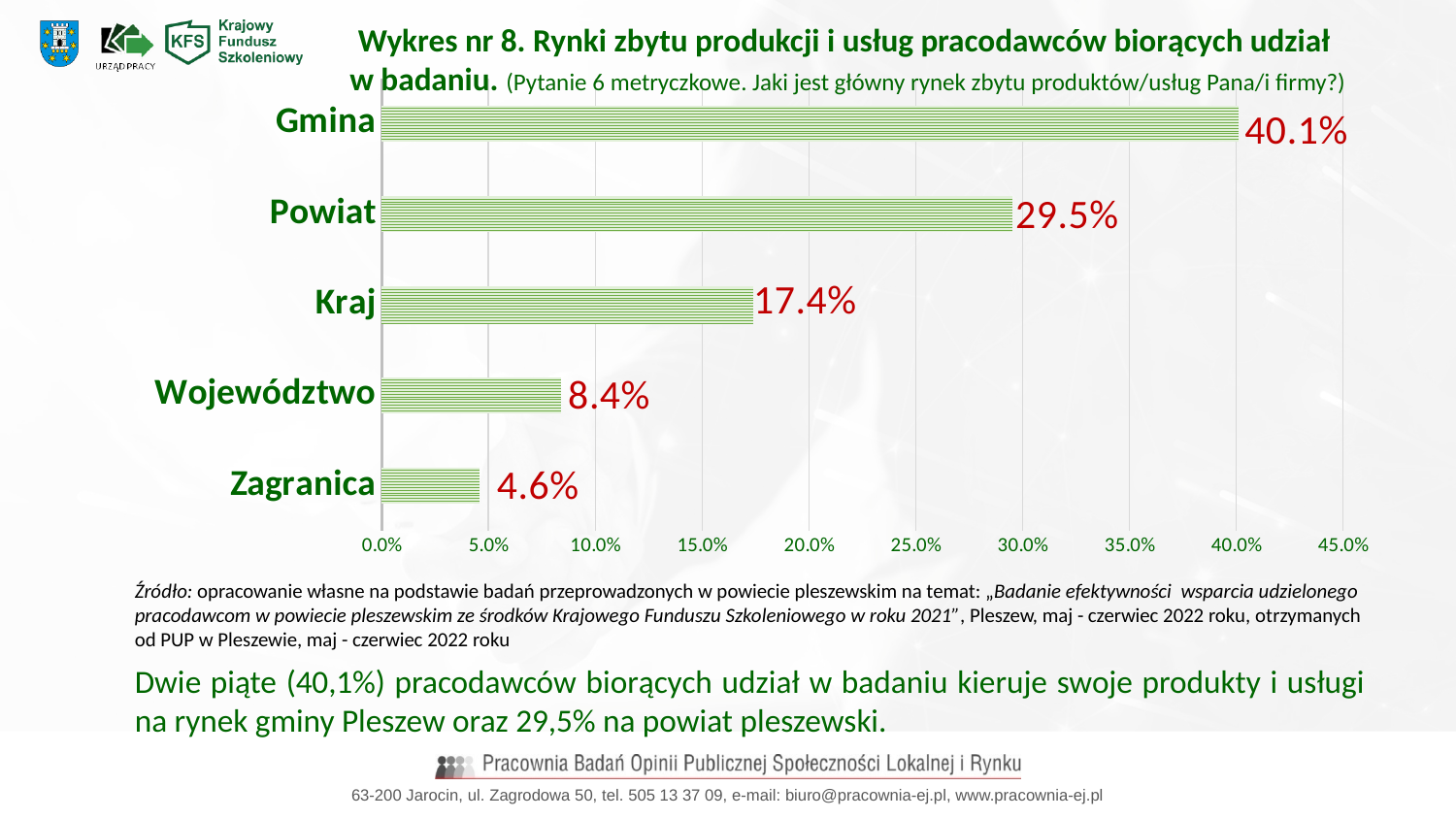
What is the difference between the values for Gmina and Powiat? 10.6% What is the value for Zagranica? 4.6% How many categories are shown in the chart? 5 What is the value for Gmina? 40.1% Which is larger, the value for Kraj or the value for Województwo? Kraj Which category has the lowest value? Zagranica What is the value for Kraj? 17.4% What is the value for Powiat? 29.5% What is the maximum value shown on the horizontal axis? 45.0% What kind of chart is shown on the slide? Bar chart What is the value for Województwo? 8.4% Which category has the highest value? Gmina